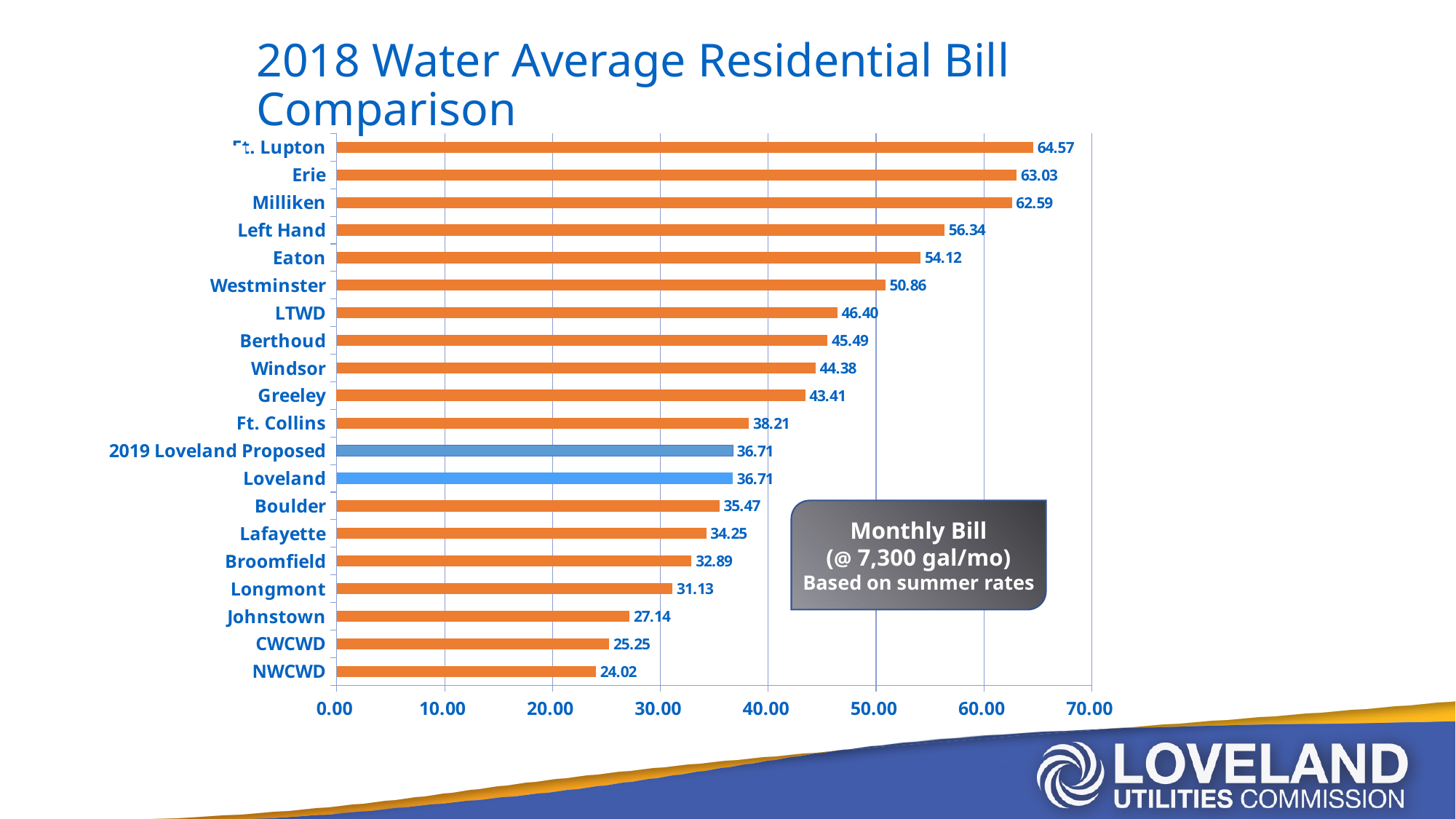
Which category has the lowest value? NWCWD What is the value for 2019 Loveland Proposed? 36.71 Which category has the highest value? Ft. Lupton Which is larger, the value for Eaton or the value for Left Hand? Left Hand What is the difference between the values for Ft. Lupton and NWCWD? 40.55 What is the value for Westminster? 50.86 Is the value for Berthoud greater or less than 40.00? greater What kind of chart is shown on the slide? bar chart What is the value for Ft. Collins? 38.21 What is the difference between the values for Greeley and Loveland? 6.70 How many categories are shown on the chart? 20 Which two bars are coloured blue instead of orange? 2019 Loveland Proposed and Loveland